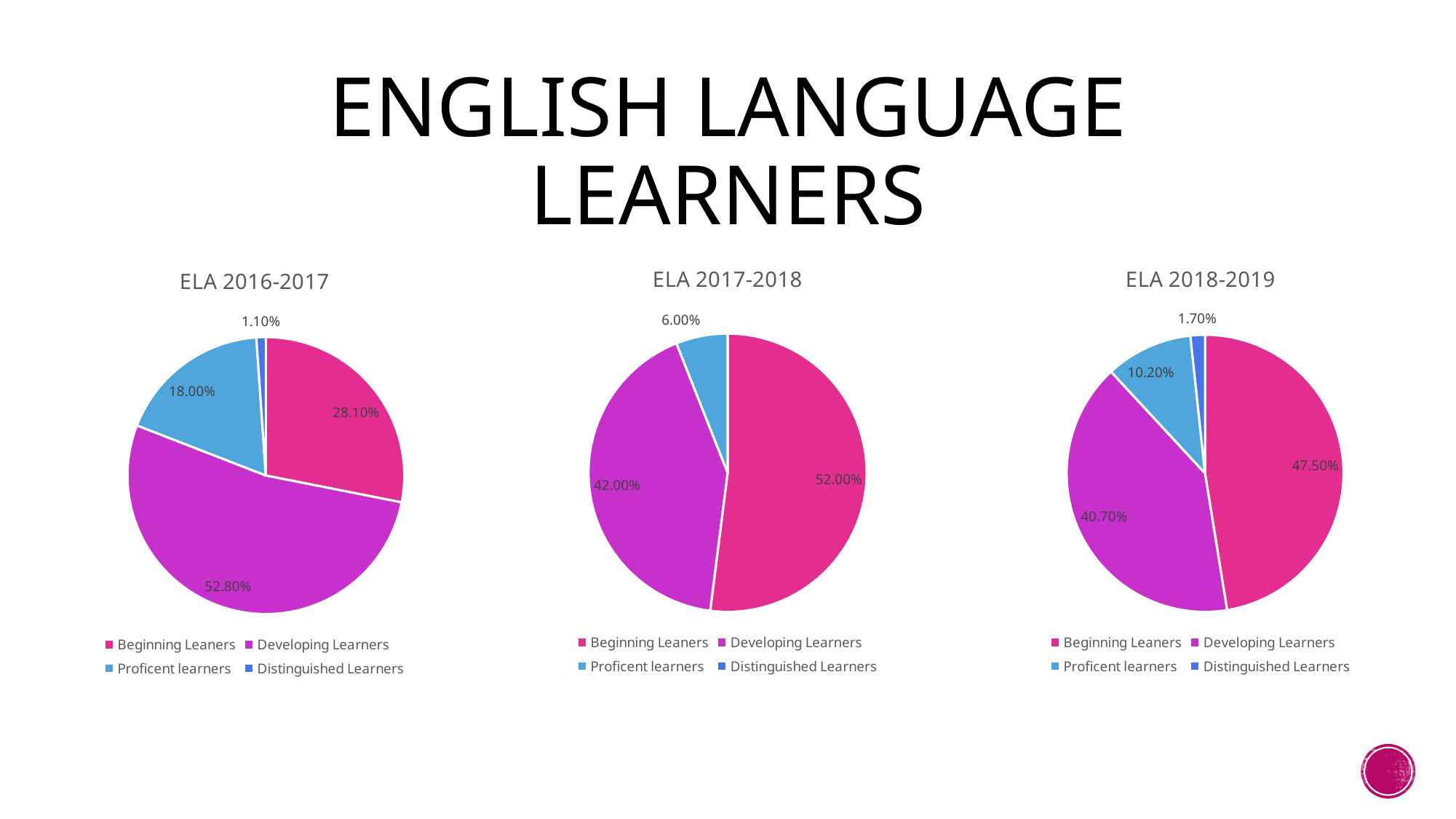
What type of chart is the ELA 2017-2018 chart? Pie chart In the ELA 2017-2018 chart, which labelled category has the smallest slice? Proficent learners In the ELA 2016-2017 chart, which category has the smallest slice? Distinguished Learners In the ELA 2016-2017 chart, which category has the largest slice? Developing Learners In the ELA 2018-2019 chart, which is larger, Beginning Leaners or Developing Learners? Beginning Leaners In the ELA 2017-2018 chart, what percentage is shown for Beginning Leaners? 52.00% In the ELA 2017-2018 chart, what is the difference between the Beginning Leaners and Developing Learners percentages? 10.00% How many series does the legend of the ELA 2016-2017 chart list? 4 In the ELA 2018-2019 chart, what percentage is shown for Distinguished Learners? 1.70% In the ELA 2018-2019 chart, which category has the largest slice? Beginning Leaners In the ELA 2016-2017 chart, what percentage is shown for Developing Learners? 52.80% In the ELA 2018-2019 chart, what percentage is shown for Proficent learners? 10.20%